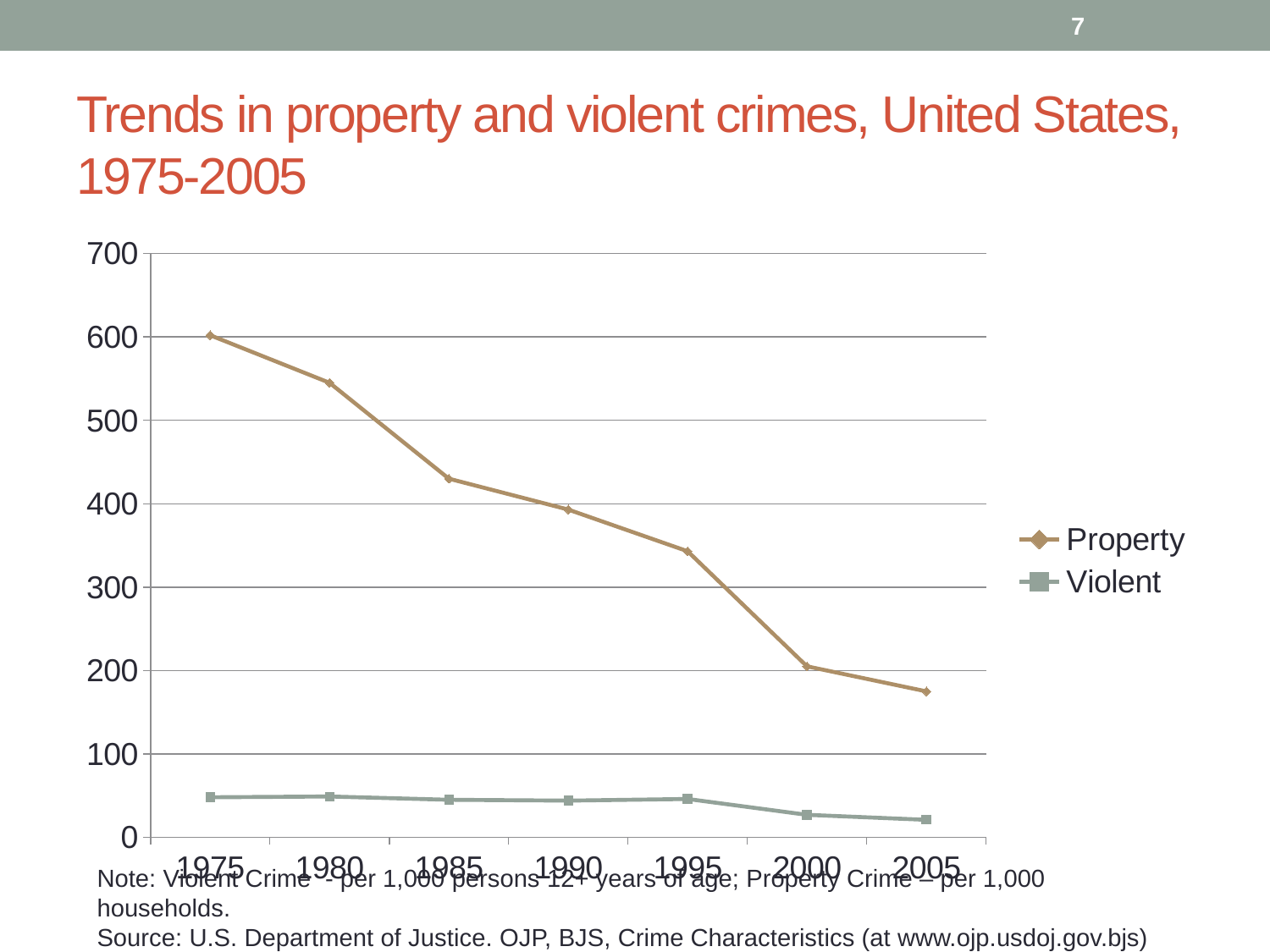
Does the Property series rise or fall from 1975 to 2005? fall What are the two series named in the legend? Property and Violent In which year is the Property series at its highest? 1975 Does the Violent series rise or fall overall from 1975 to 2005? fall How many series does the legend list? 2 What kind of chart is shown on the slide? line chart How many years are plotted along the x axis? 7 In 1975, which series has the larger value, Property or Violent? Property In which year is the Property series at its lowest? 2005 Is the Property value for 2005 greater or less than 200? less Is the Violent value for 1975 greater or less than 100? less